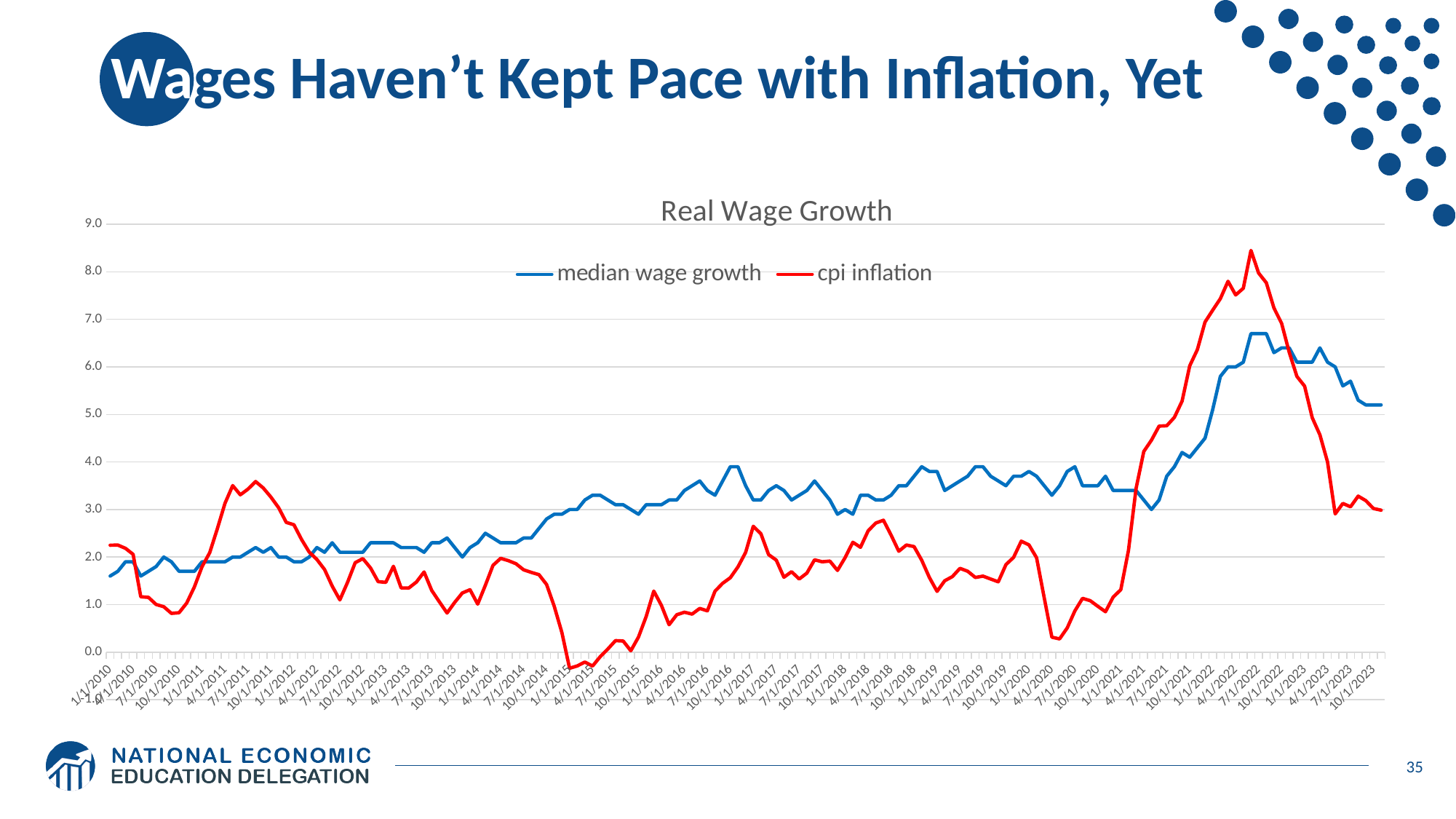
Does cpi inflation rise or fall between 7/1/2022 and 10/1/2023? fall Is the highest value reached by cpi inflation greater or less than 8.0? greater Which series reaches the highest value anywhere on the chart? cpi inflation What kind of chart is shown on the slide? line chart Is the value for median wage growth at 1/1/2010 greater or less than 2.0? less Is the highest value reached by median wage growth greater or less than 6.0? greater What colour is the cpi inflation line in the chart? red At 10/1/2023, which series is higher, median wage growth or cpi inflation? median wage growth What is the title of the chart? Real Wage Growth At 7/1/2022, which series is higher, median wage growth or cpi inflation? cpi inflation How many series does the legend of the chart list? 2